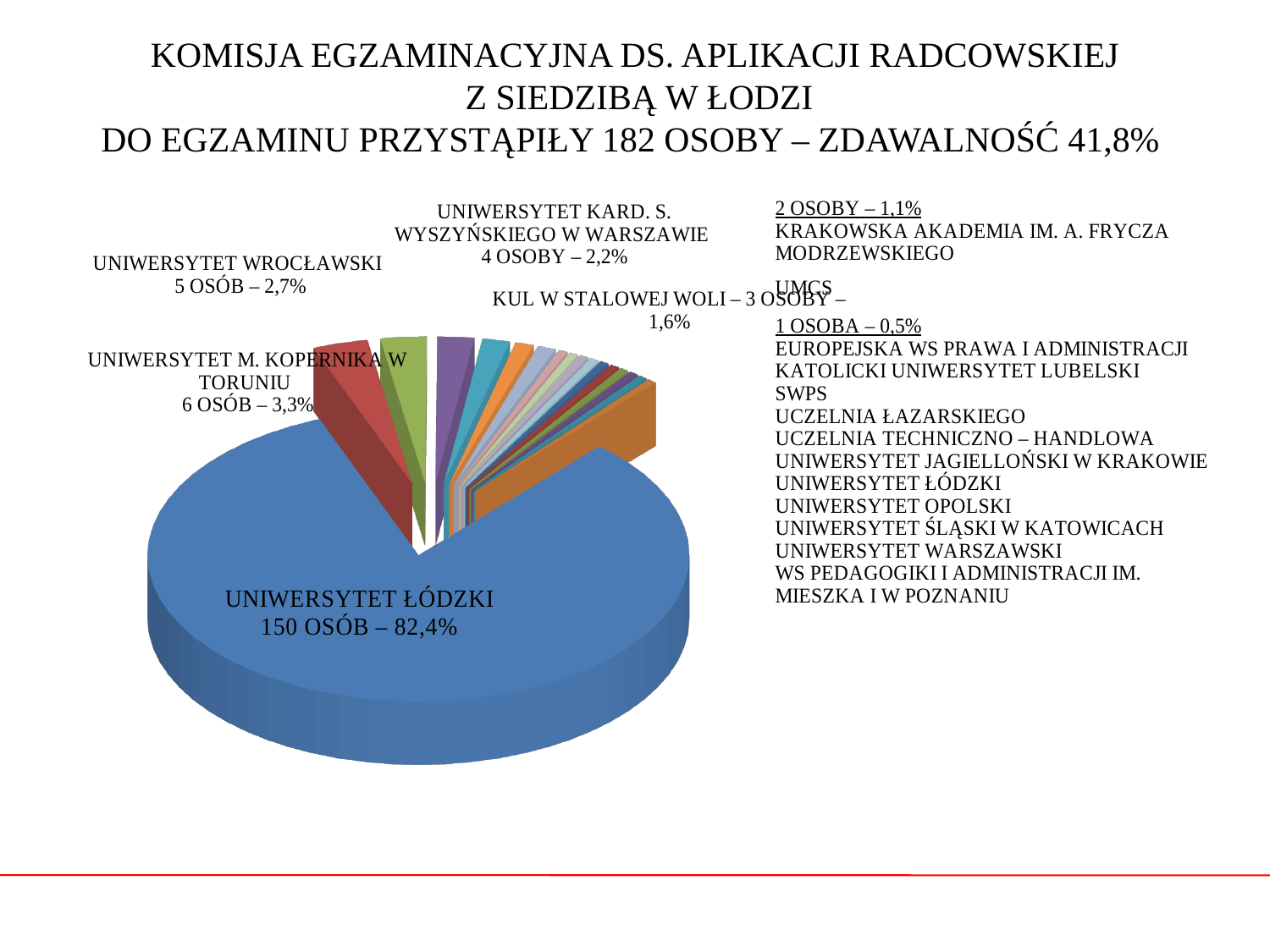
What kind of chart is shown on the slide? pie chart What percentage is shown for Uniwersytet Wrocławski? 2,7% What percentage is shown for the universities with 2 people each, such as UMCS? 1,1% How many people from Uniwersytet M. Kopernika w Toruniu took the exam? 6 osób According to the slide title, how many people took the exam in total? 182 osoby How many people from Uniwersytet Kard. S. Wyszyńskiego w Warszawie took the exam? 4 osoby Which university has the largest slice of the pie? Uniwersytet Łódzki What percentage is shown for KUL w Stalowej Woli? 1,6% What is the difference in the number of people between Uniwersytet Łódzki and Uniwersytet M. Kopernika w Toruniu? 144 How many people from Uniwersytet Łódzki took the exam according to the chart? 150 osób Which has more people: Uniwersytet Wrocławski or KUL w Stalowej Woli? Uniwersytet Wrocławski